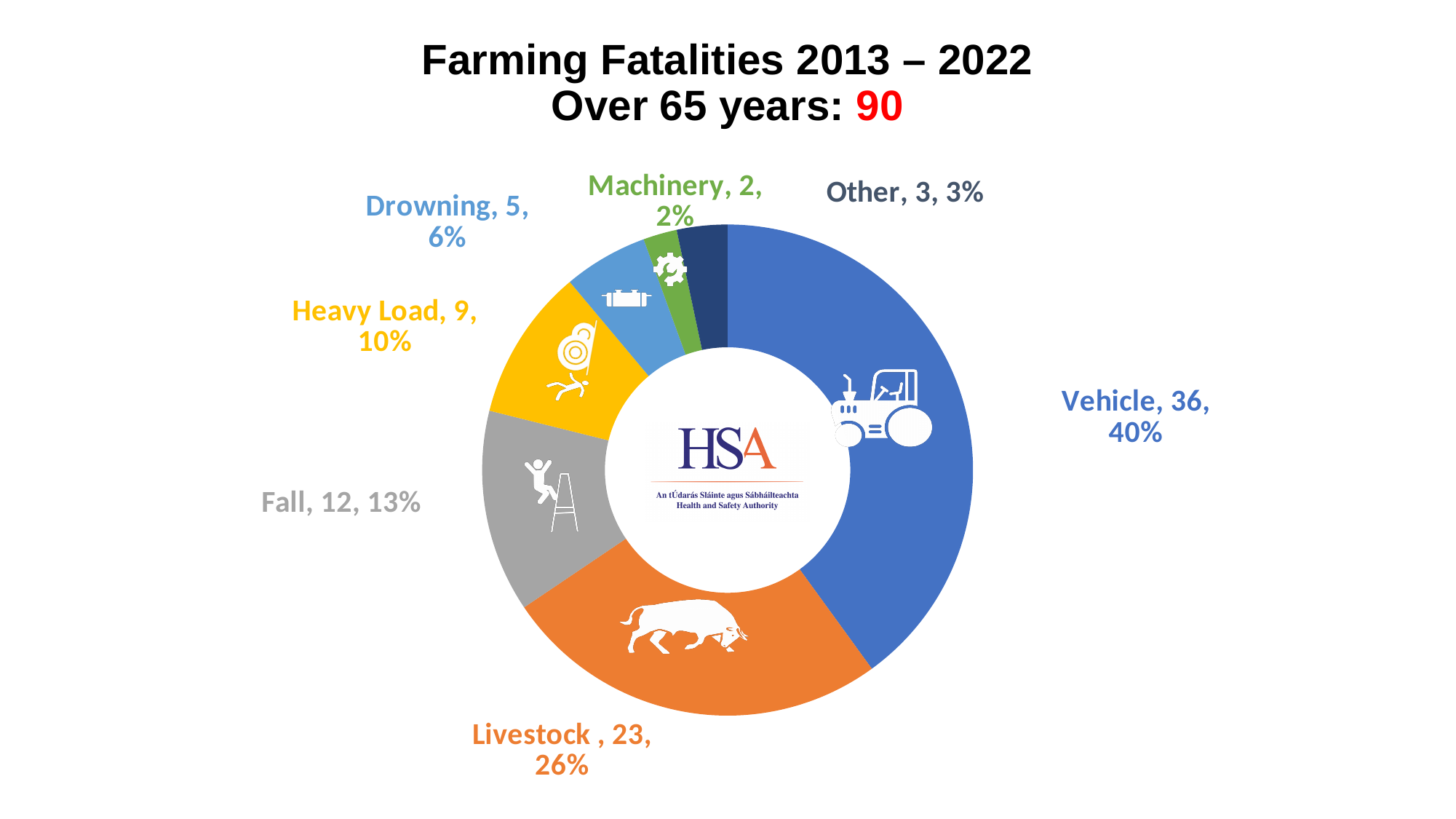
What is the difference between the Vehicle and Livestock fatality counts? 13 What percentage of fatalities is attributed to Drowning? 6% How many categories are shown in the chart? 7 Which is larger, the number of fatalities from Fall or from Heavy Load? Fall What kind of chart is shown on the slide? Pie chart (doughnut) What is the total number of fatalities for those over 65 years shown in the title? 90 Which category has the lowest number of fatalities? Machinery How many fatalities are in the Other category? 3 What is the title of the chart? Farming Fatalities 2013 – 2022 Over 65 years: 90 What share of the pie does Livestock account for? 26% Which category has the highest number of fatalities? Vehicle How many farming fatalities among those over 65 years were caused by Vehicle? 36